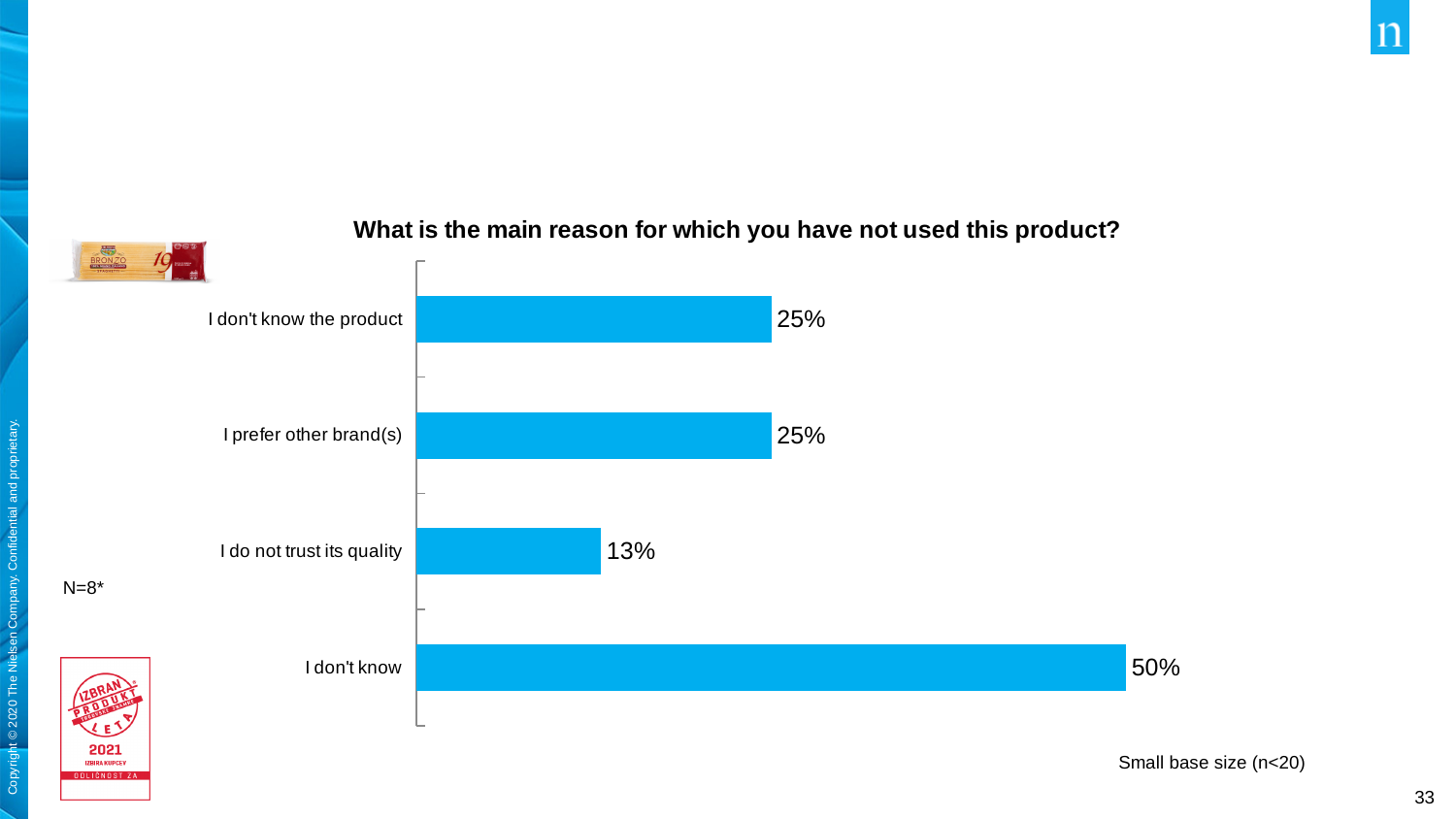
What is the value for "I don't know the product"? 25% What is the value for "I do not trust its quality"? 13% Which category has the highest value? I don't know What is the value for "I don't know"? 50% What is the title of the chart? What is the main reason for which you have not used this product? Which category has the lowest value? I do not trust its quality What is the value for "I prefer other brand(s)"? 25% Which is larger, "I don't know" or "I don't know the product"? I don't know What is the difference between "I don't know" and "I prefer other brand(s)"? 25% How many categories are shown in the chart? 4 What kind of chart is shown on the slide? Bar chart What is the difference between "I don't know" and "I do not trust its quality"? 37%